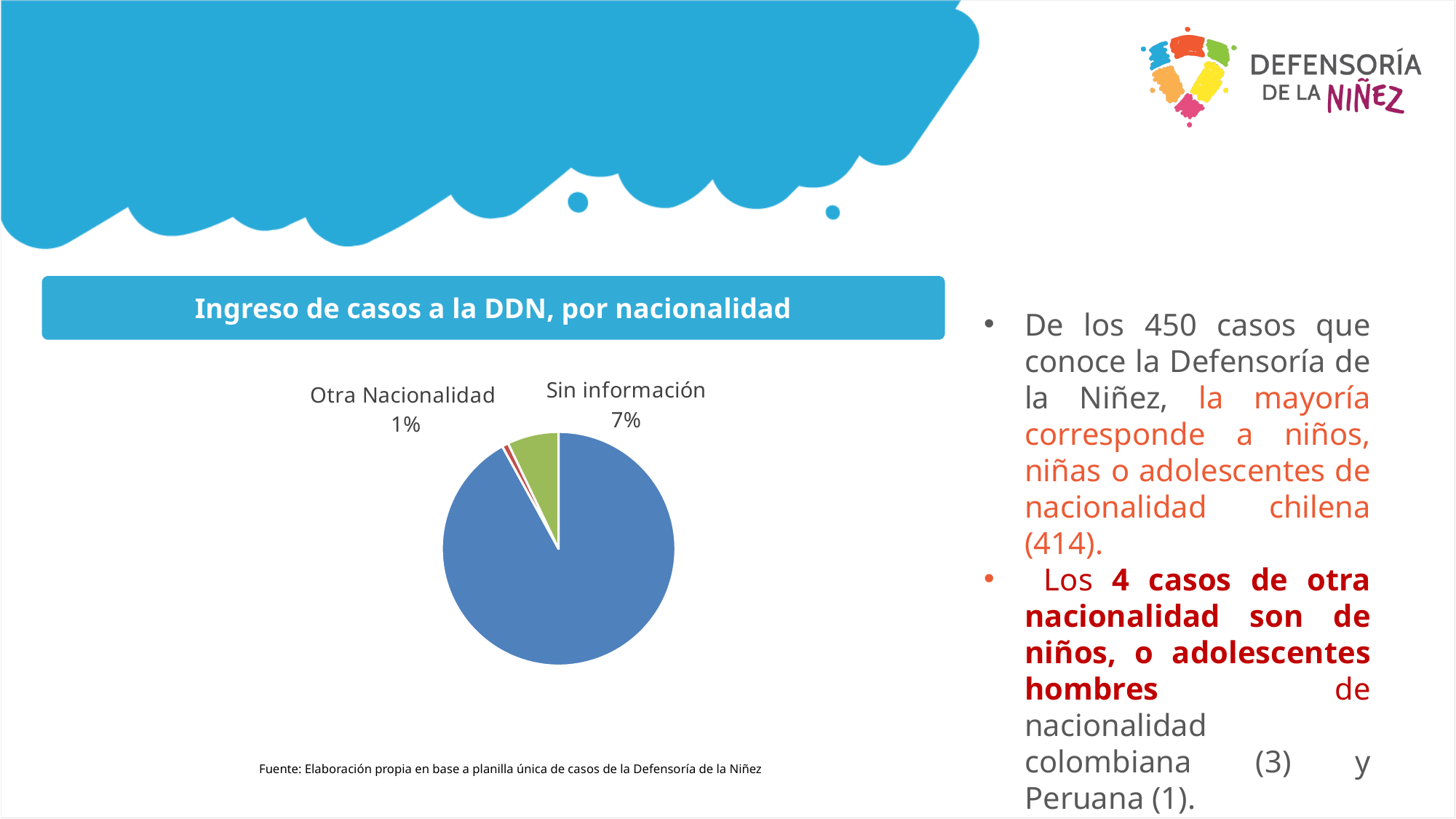
What is the value shown for 'Sin información'? 7% What is the value shown for 'Otra Nacionalidad'? 1% Which of the labeled slices is the smallest? Otra Nacionalidad How many slices does the pie chart have? 3 What share of the pie does the 'Sin información' slice represent? 7% What is the title of the chart? Ingreso de casos a la DDN, por nacionalidad What share of the pie does the 'Otra Nacionalidad' slice represent? 1% What kind of chart is shown on the slide? Pie chart Which is larger, the 'Sin información' slice or the 'Otra Nacionalidad' slice? Sin información What is the difference in percentage points between 'Sin información' and 'Otra Nacionalidad'? 6% What colour is the 'Sin información' slice? Green